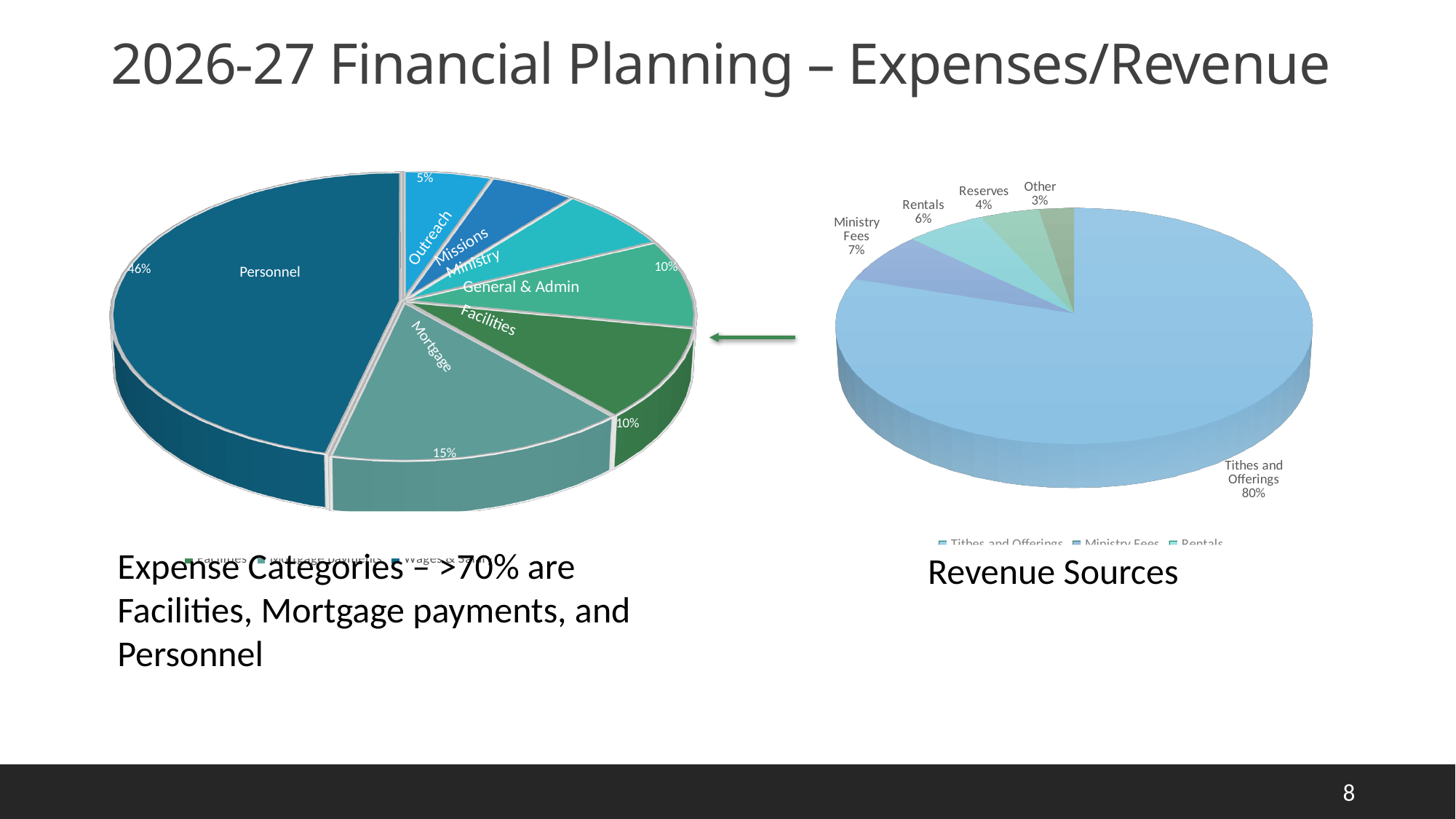
In the Revenue Sources pie chart, how many percentage points larger is Tithes and Offerings than Ministry Fees? 73 In the Expense Categories pie chart on the left, what share does Personnel make up? 46% In the Revenue Sources pie chart, which is larger, Rentals or Reserves? Rentals What type of chart is used for the Revenue Sources on the right? Pie chart In the Revenue Sources pie chart, how many revenue sources are shown? 5 In the Expense Categories pie chart on the left, which category is the largest? Personnel In the Revenue Sources pie chart, what percentage comes from Ministry Fees? 7% In the Revenue Sources pie chart, which source is the largest? Tithes and Offerings In the Revenue Sources pie chart, what share do Tithes and Offerings make up? 80% In the Expense Categories pie chart on the left, what percentage is Mortgage? 15% In the Revenue Sources pie chart, which source is the smallest? Other In the Revenue Sources pie chart, what percentage comes from Rentals? 6%